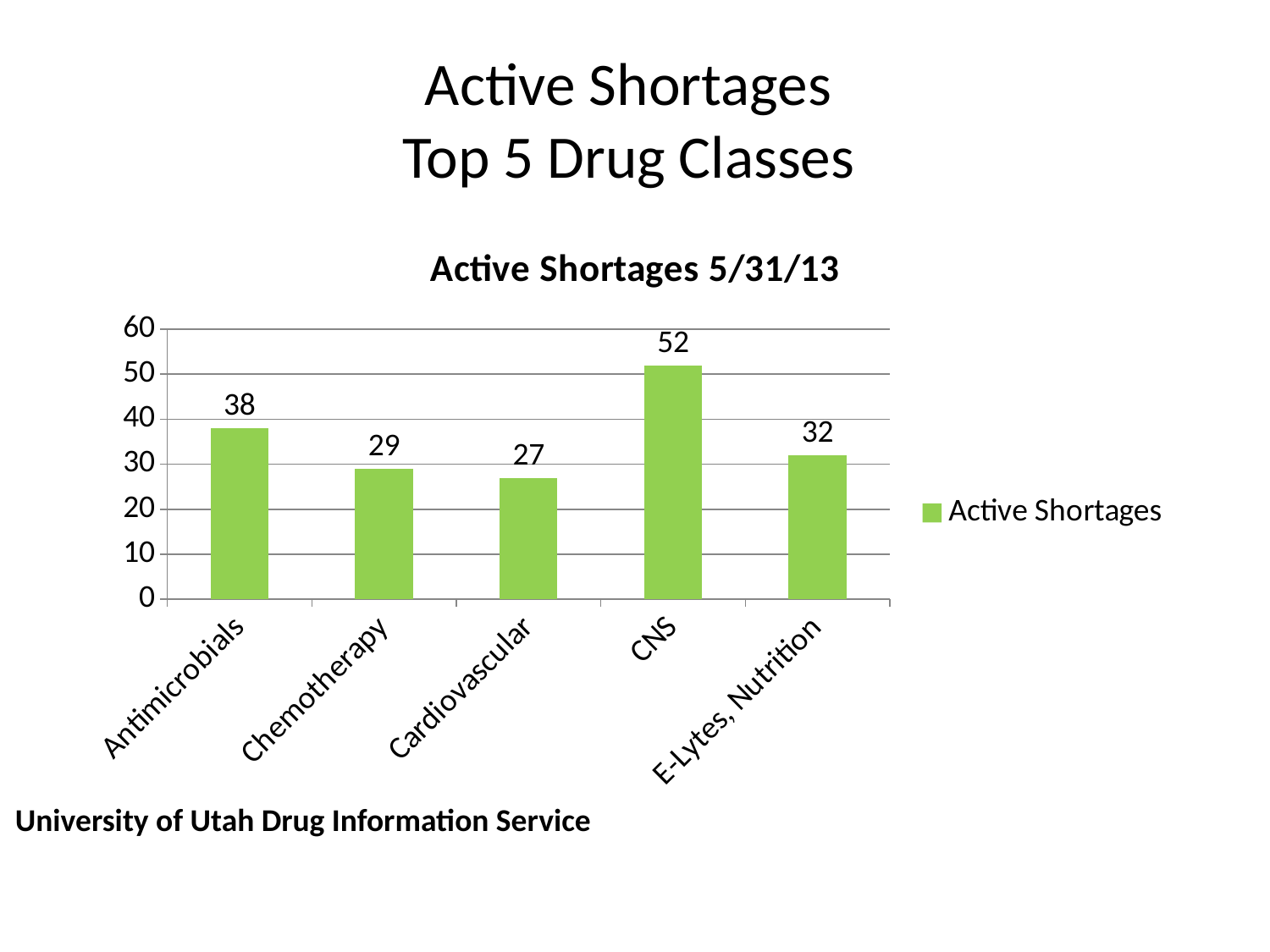
What type of chart is shown on the slide? bar chart Which has more active shortages, Antimicrobials or E-Lytes, Nutrition? Antimicrobials Which drug class has the highest number of active shortages? CNS What is the number of active shortages for CNS? 52 Which drug class has the lowest number of active shortages? Cardiovascular What is the number of active shortages for E-Lytes, Nutrition? 32 What is the title of the chart? Active Shortages 5/31/13 Is the value for CNS greater or less than 50? greater What is the difference between the active shortages for Chemotherapy and Cardiovascular? 2 What is the number of active shortages for Antimicrobials? 38 How many drug classes are shown in the chart? 5 What is the difference between the active shortages for CNS and Antimicrobials? 14